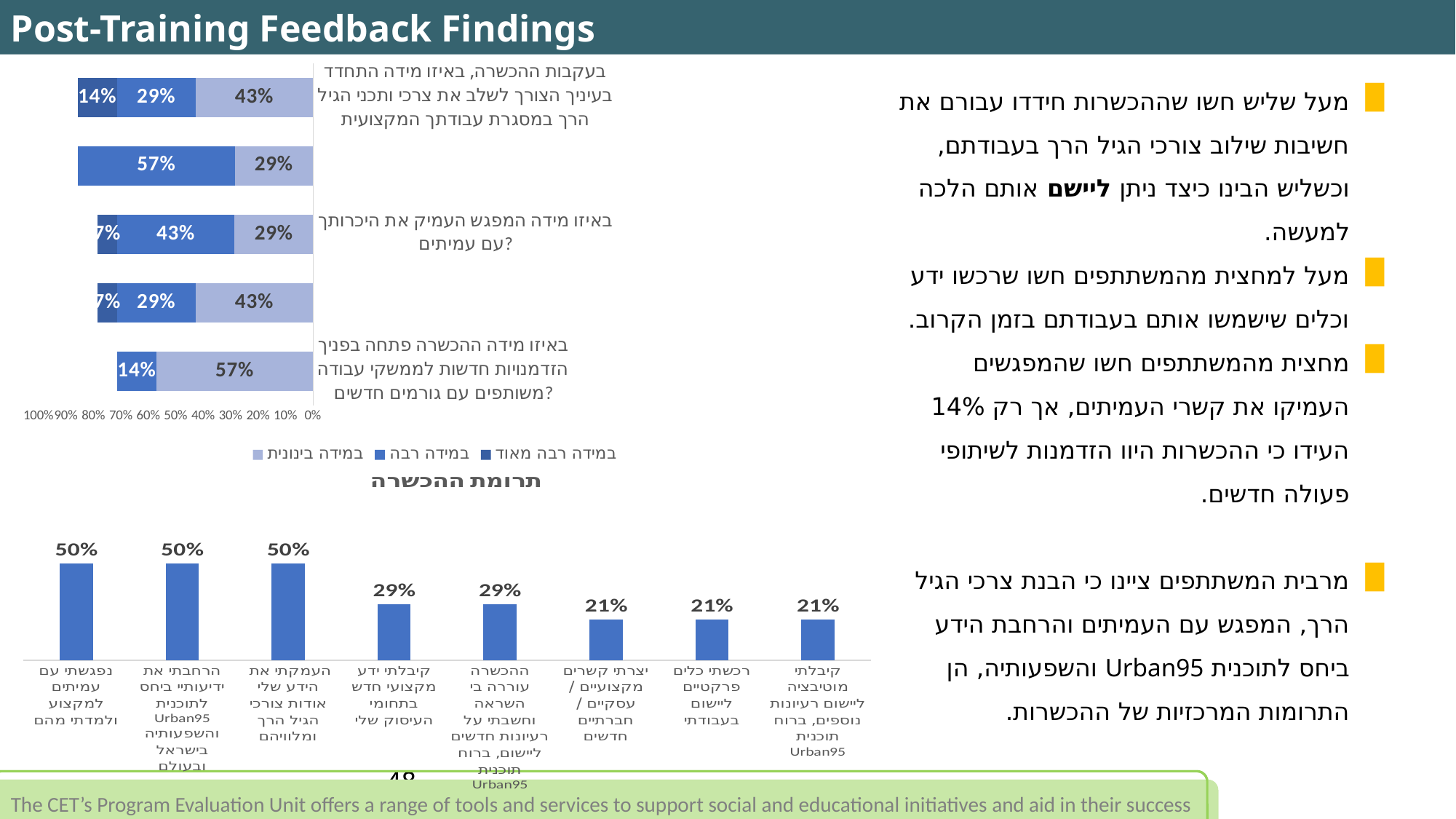
In the bottom chart titled תרומת ההכשרה, what is the value for רכשתי כלים פרקטיים ליישום בעבודתי? 21% In the bottom chart titled תרומת ההכשרה, what is the value for קיבלתי ידע מקצועי חדש בתחומי העיסוק שלי? 29% In the bottom chart titled תרומת ההכשרה, what is the difference between the value for נפגשתי עם עמיתים למקצוע ולמדתי מהם and the value for יצרתי קשרים מקצועיים / עסקיים / חברתיים חדשים? 29% In the top stacked bar chart, which series is shown in the lightest blue colour according to the legend? במידה בינונית In the bottom chart titled תרומת ההכשרה, how many categories are plotted? 8 In the top stacked bar chart, what is the value of the במידה בינונית segment for the category באיזו מידה ההכשרה פתחה בפניך הזדמנויות חדשות למשקי עבודה משותפים עם גורמים חדשים? 57% In the bottom chart titled תרומת ההכשרה, what is the lowest value shown? 21% In the top stacked bar chart, what is the value of the במידה רבה segment for the category באיזו מידה המפגש העמיק את היכרותך עם עמיתים? 43% What kind of chart is the bottom chart titled תרומת ההכשרה? bar chart In the top stacked bar chart, what is the total of the three segments for the category בעקבות ההכשרה, באיזו מידה התחדד בעיניך הצורך לשלב את צרכי ותכני הגיל הרך במסגרת עבודתך המקצועית? 86% In the top stacked bar chart, how many series does the legend list? 3 In the bottom chart titled תרומת ההכשרה, which is larger: the value for העמקתי את הידע שלי אודות צורכי הגיל הרך ומלוויהם or the value for קיבלתי מוטיבציה ליישום רעיונות נוספים, ברוח תוכנית Urban95? העמקתי את הידע שלי אודות צורכי הגיל הרך ומלוויהם